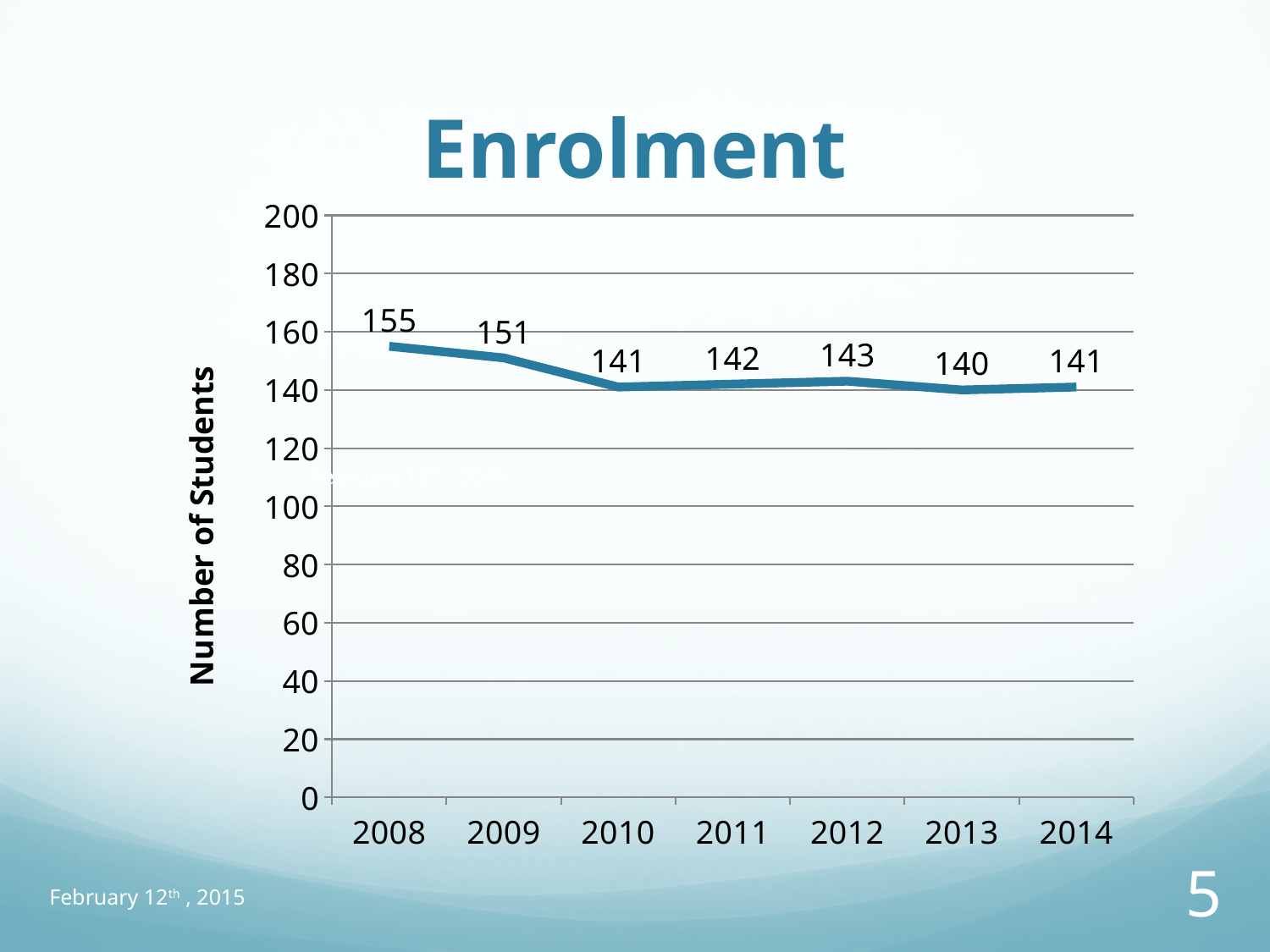
What was the enrolment in 2008? 155 Which year had the lowest enrolment? 2013 What is the label of the vertical axis? Number of Students Which year had the highest enrolment? 2008 Which year had higher enrolment, 2009 or 2012? 2009 What is the difference in enrolment between 2009 and 2014? 10 What kind of chart is shown on the slide? line chart Is the enrolment for 2011 greater or less than 160? less How many years are plotted on the chart? 7 What is the difference in enrolment between 2008 and 2010? 14 What was the enrolment in 2012? 143 What was the enrolment in 2013? 140